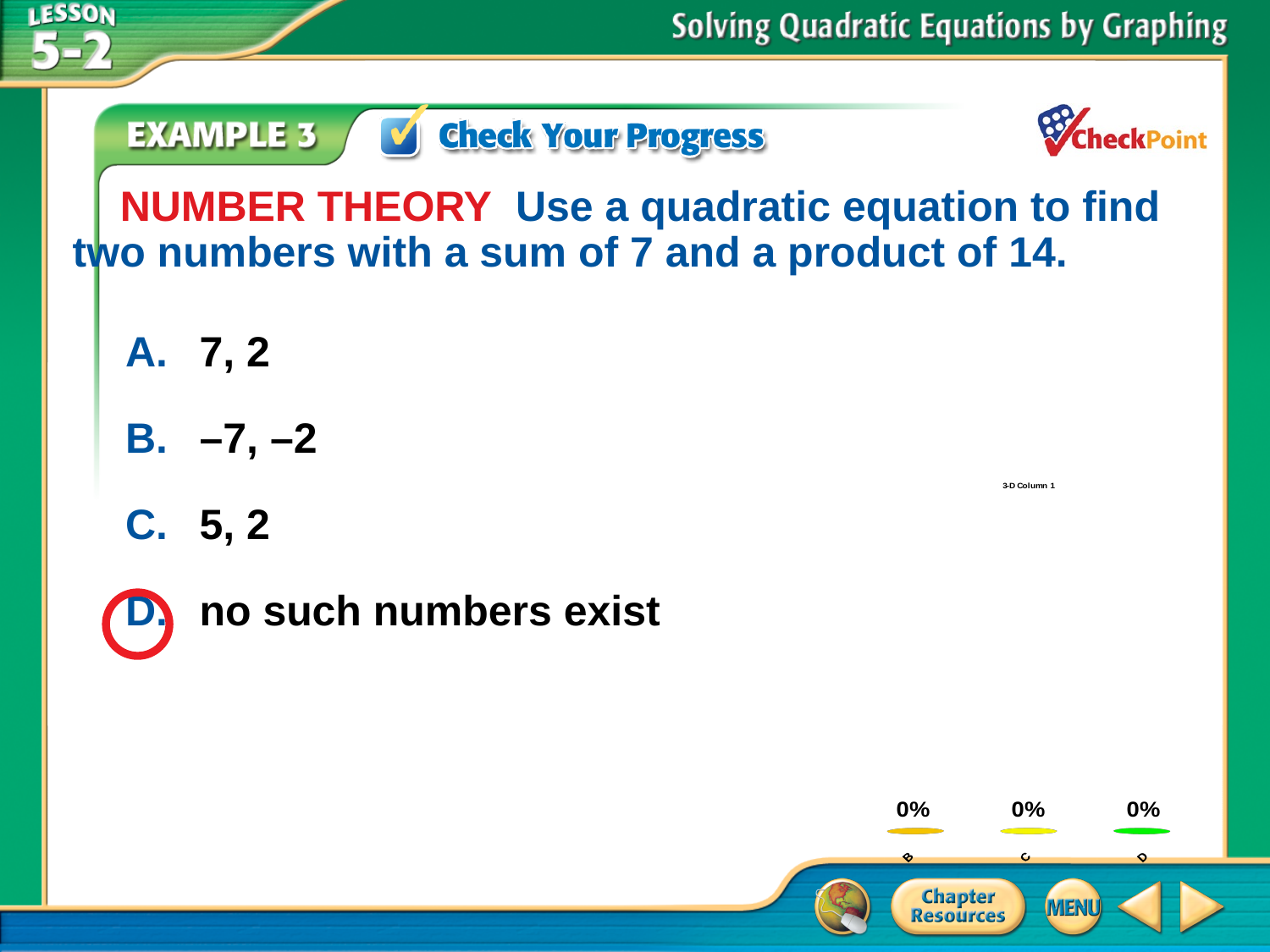
In the chart at the bottom right of the slide, what colour is the bar for category D? green In the chart at the bottom right, what is the difference between the values for C and D? 0% In the chart at the bottom right of the slide, what value is shown for category B? 0% In the chart at the bottom right of the slide, what value is shown for category D? 0% In the chart at the bottom right of the slide, what value is shown for category C? 0% How many data labels reading 0% are shown in the chart at the bottom right of the slide? 3 What kind of chart is shown at the bottom right of the slide? bar chart In the chart at the bottom right, what is the difference between the values for B and C? 0%